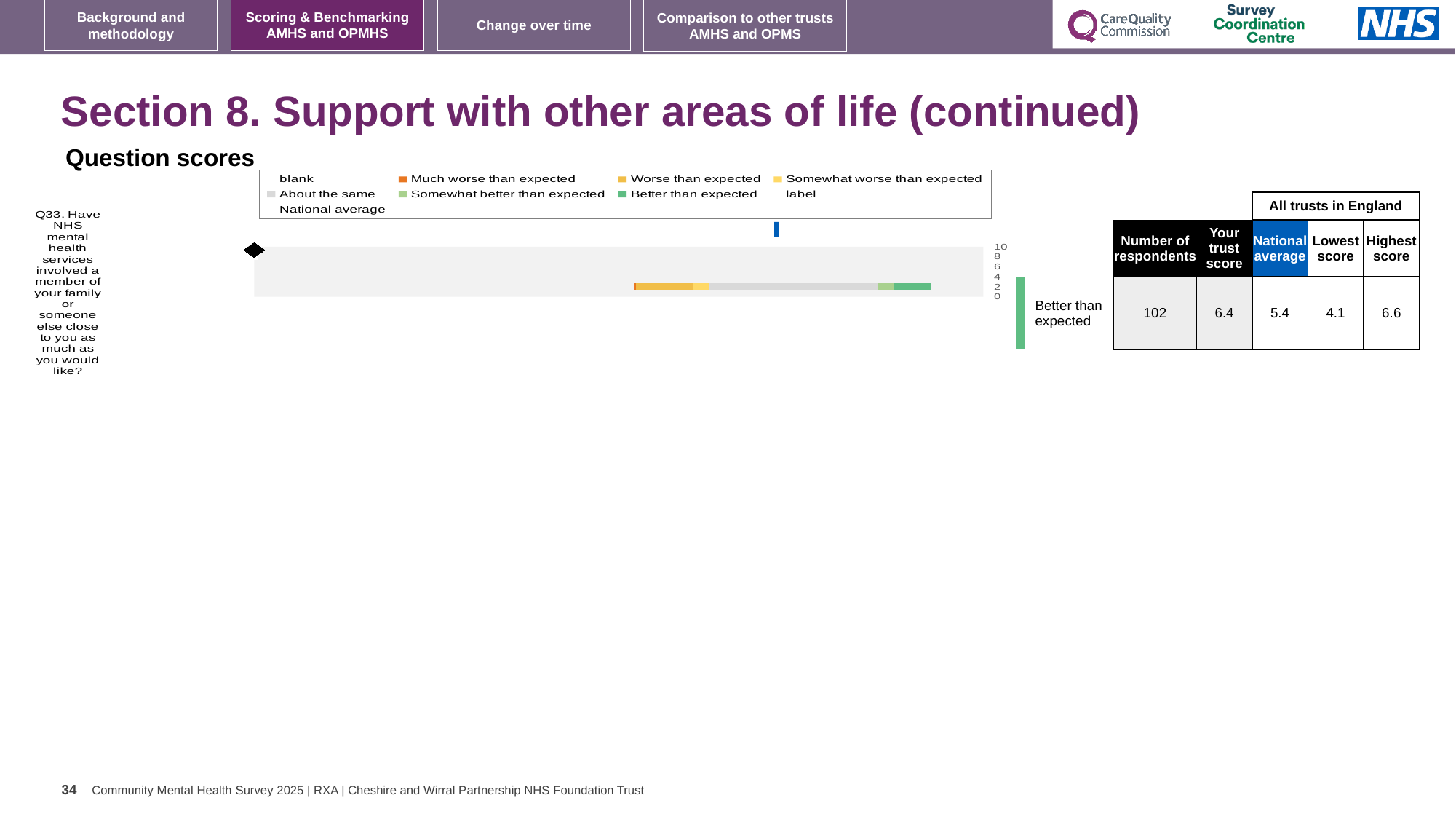
Which question number is plotted in the chart? Q33 In the table beside the chart, is the trust score for Q33 larger or smaller than the national average? larger What benchmark rating is printed to the right of the chart for Q33? Better than expected In the table beside the chart, what is the number of respondents for Q33? 102 What kind of chart is shown under 'Question scores'? bar chart In the table beside the chart, what is the difference between the trust score and the national average for Q33? 1.0 In the table beside the chart, what is the 'Your trust score' for Q33? 6.4 In the table beside the chart, what is the lowest score among all trusts in England for Q33? 4.1 In the table beside the chart, what is the highest score among all trusts in England for Q33? 6.6 How many questions (categories) are plotted in the chart? 1 In the table beside the chart, what is the national average score for Q33? 5.4 What colour is the 'Better than expected' legend entry in the chart? green